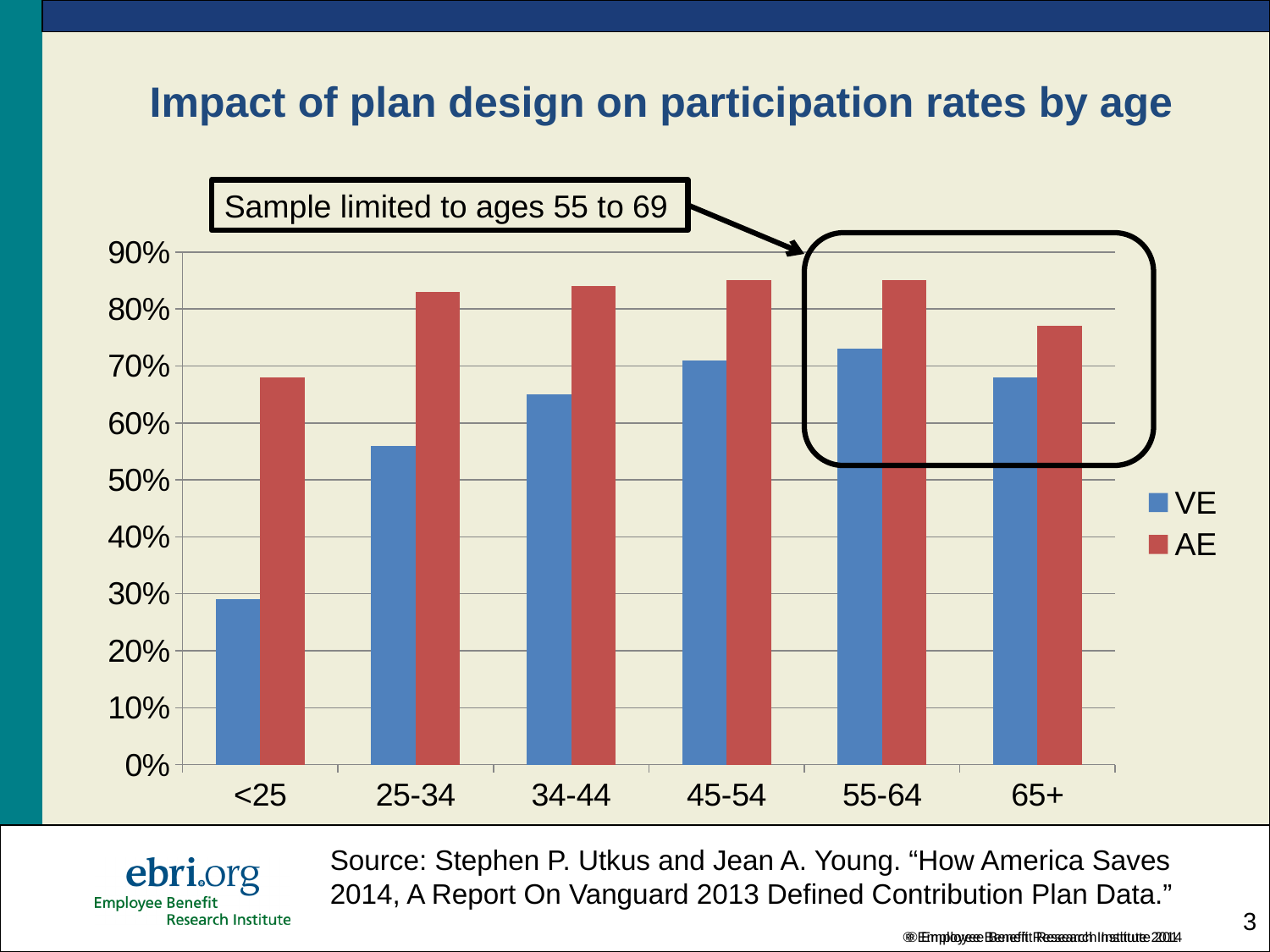
Is the VE value for <25 greater or less than 40%? less Which age group has the lowest AE value? <25 What colour are the AE bars? red Which age group has the lowest VE value? <25 Is the AE value for 25-34 greater or less than 80%? greater Does the AE value rise or fall from <25 to 25-34? rise Is the VE value for 34-44 greater or less than 60%? greater What kind of chart is shown on the slide? bar chart How many series does the legend list? 2 How many age categories are shown on the x axis? 6 For the 25-34 age group, which is larger, VE or AE? AE